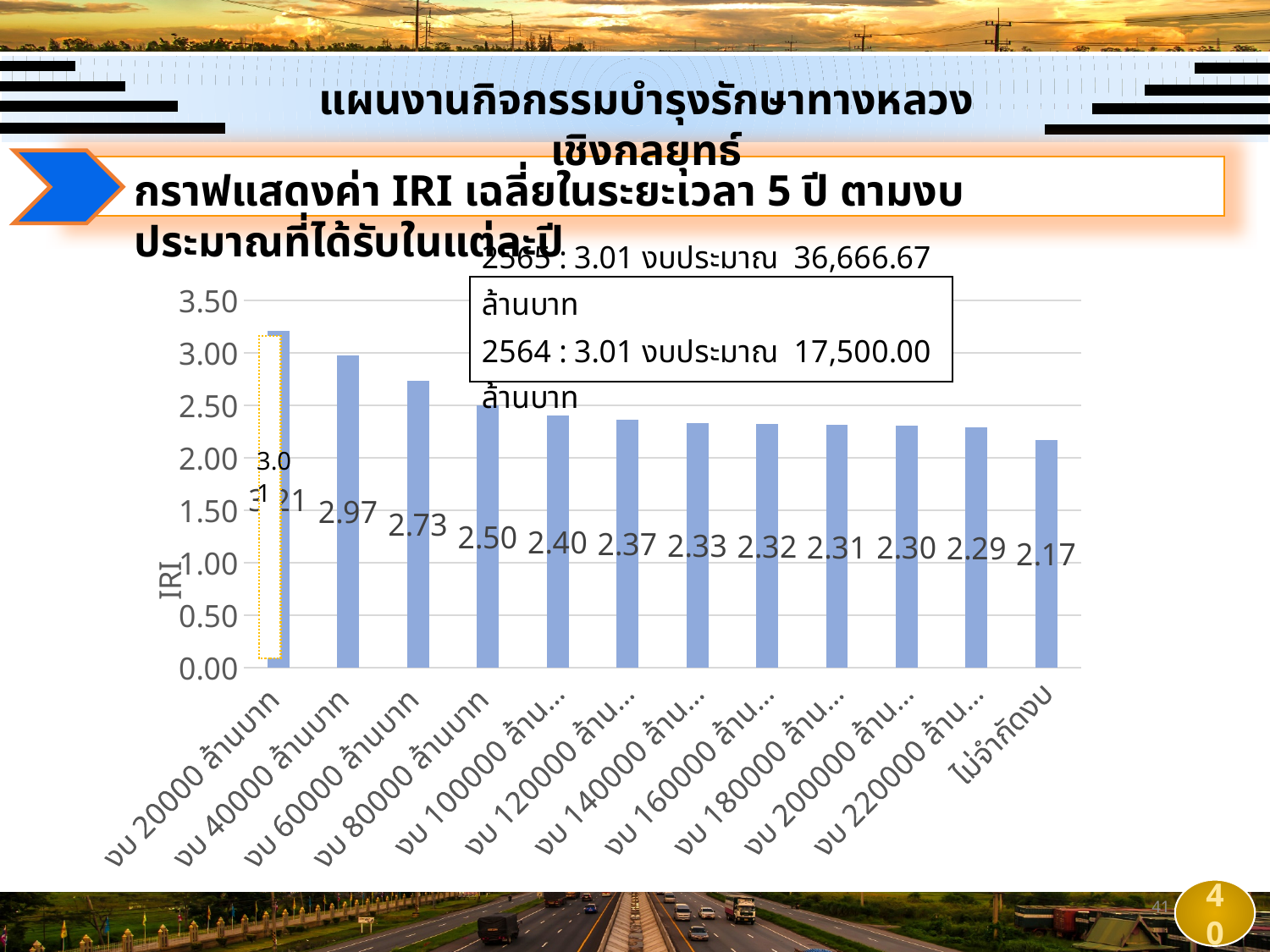
Which category has the lowest IRI value? ไม่จำกัดงบ What is the IRI value for งบ 80000 ล้านบาท? 2.50 What is the IRI value for งบ 60000 ล้านบาท? 2.73 How many categories (bars) are shown in the chart? 12 Which category has the highest IRI value? งบ 20000 ล้านบาท What is the IRI value for งบ 40000 ล้านบาท? 2.97 What kind of chart is shown on the slide? bar chart What is the difference between the IRI values for งบ 40000 ล้านบาท and งบ 80000 ล้านบาท? 0.47 Which is larger, the IRI value for งบ 60000 ล้านบาท or for ไม่จำกัดงบ? งบ 60000 ล้านบาท What is the label on the vertical axis of the chart? IRI Do the IRI values rise or fall from left to right along the x axis? fall What is the IRI value for ไม่จำกัดงบ? 2.17